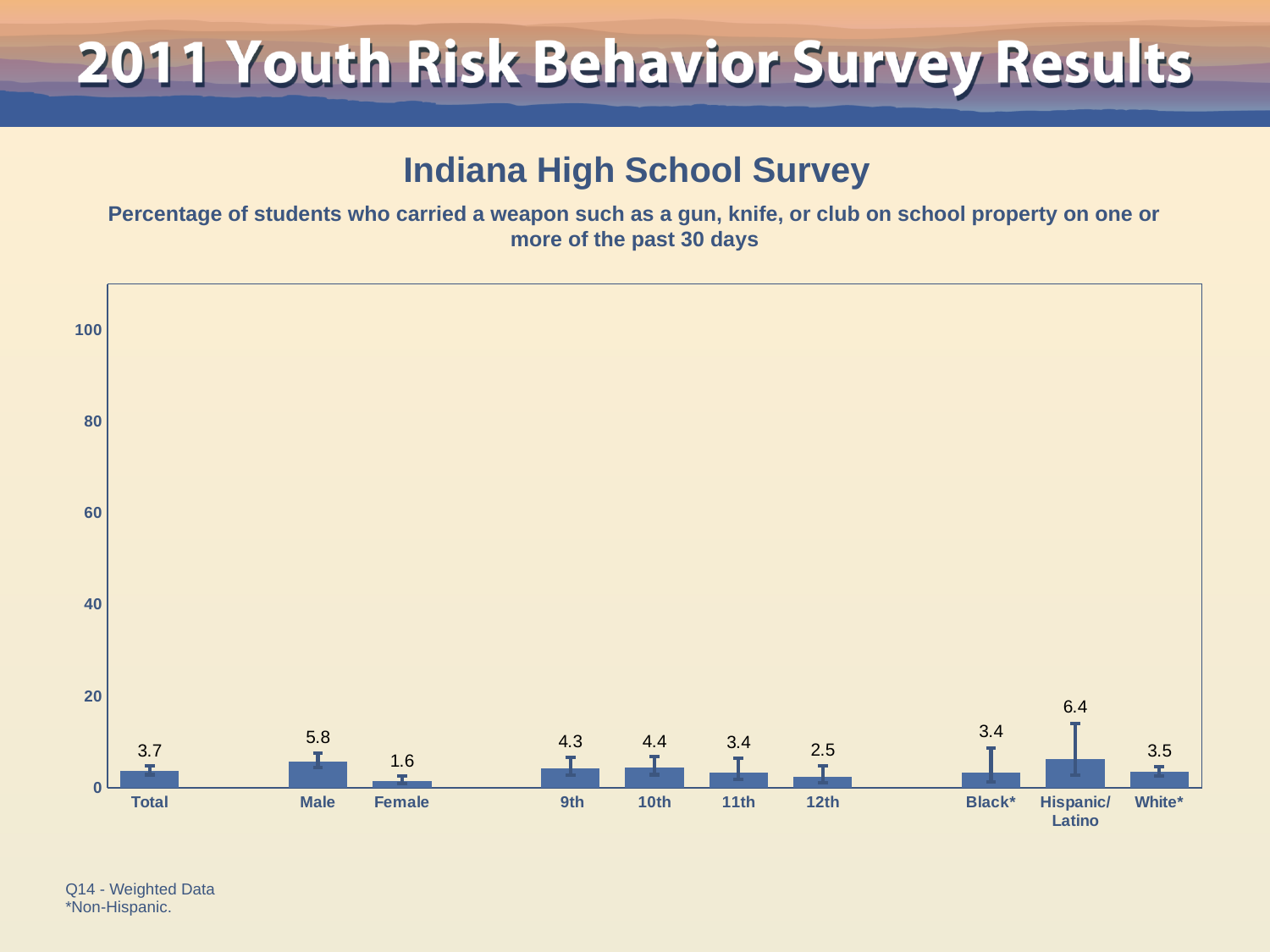
Which category has the highest value? Hispanic/Latino What is the value for Hispanic/Latino? 6.4 What is the value for Male? 5.8 Is the value for Total greater or less than 20? less What kind of chart is this? bar chart What is the value for 12th? 2.5 What is the difference between the values for Male and Female? 4.2 How many categories are shown on the x axis? 10 Which category has the lowest value? Female Do the values rise or fall from 9th to 12th grade? fall What is the value for Female? 1.6 Which is larger, the value for 9th or the value for 12th? 9th